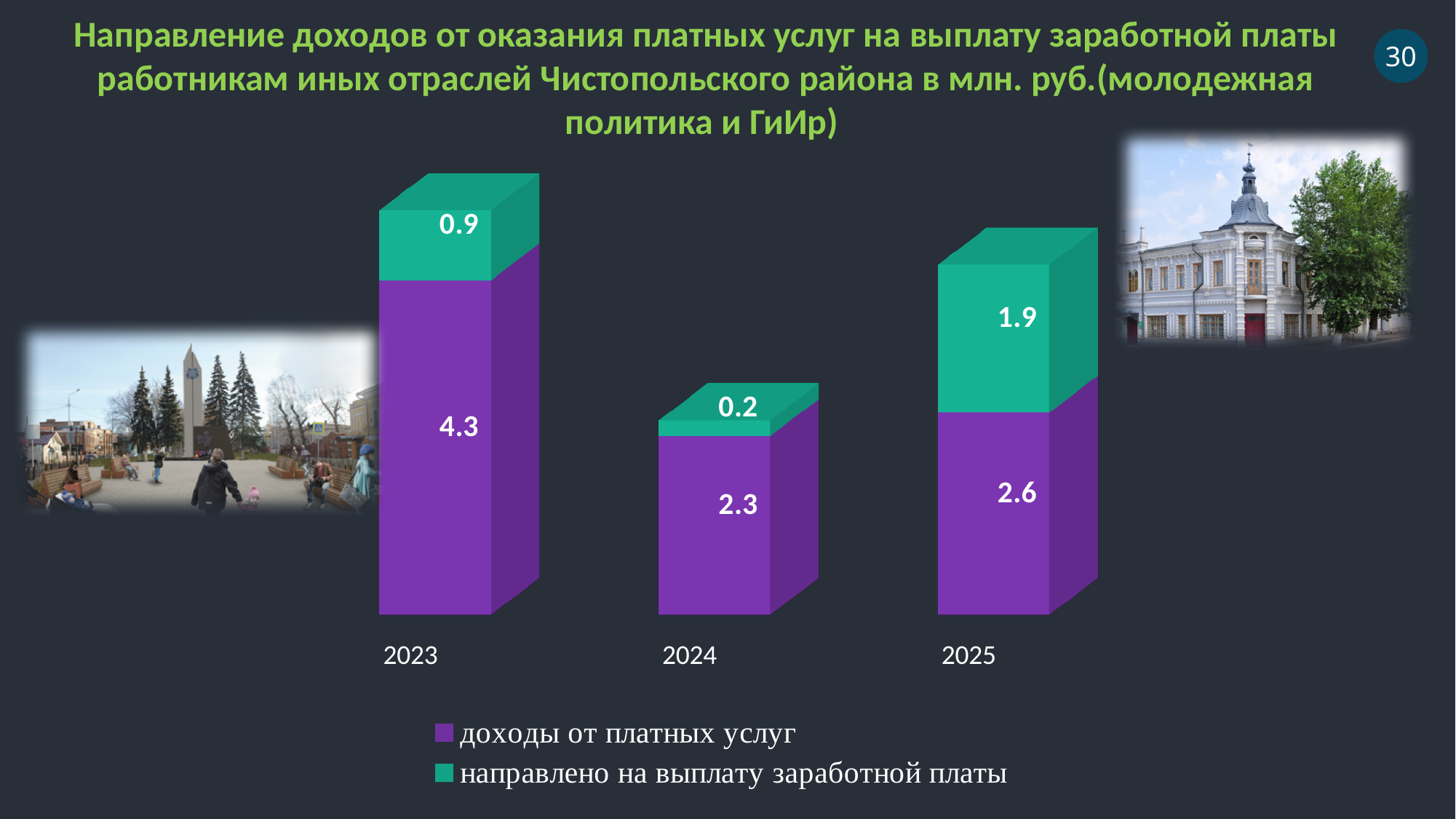
How many series does the legend list? 2 What is the value of «направлено на выплату заработной платы» for 2025? 1.9 What is the total of the stacked bar for 2025? 4.5 What is the difference between «доходы от платных услуг» in 2023 and in 2024? 2.0 Which year has the highest value for «доходы от платных услуг»? 2023 What kind of chart is shown on the slide? Stacked bar chart Which is larger: «направлено на выплату заработной платы» in 2025 or in 2023? 2025 Which colour represents «доходы от платных услуг» in the legend? Purple What is the value of «доходы от платных услуг» for 2023? 4.3 How many years are shown on the x axis? 3 What is the value of «направлено на выплату заработной платы» for 2024? 0.2 Which year has the lowest value for «направлено на выплату заработной платы»? 2024